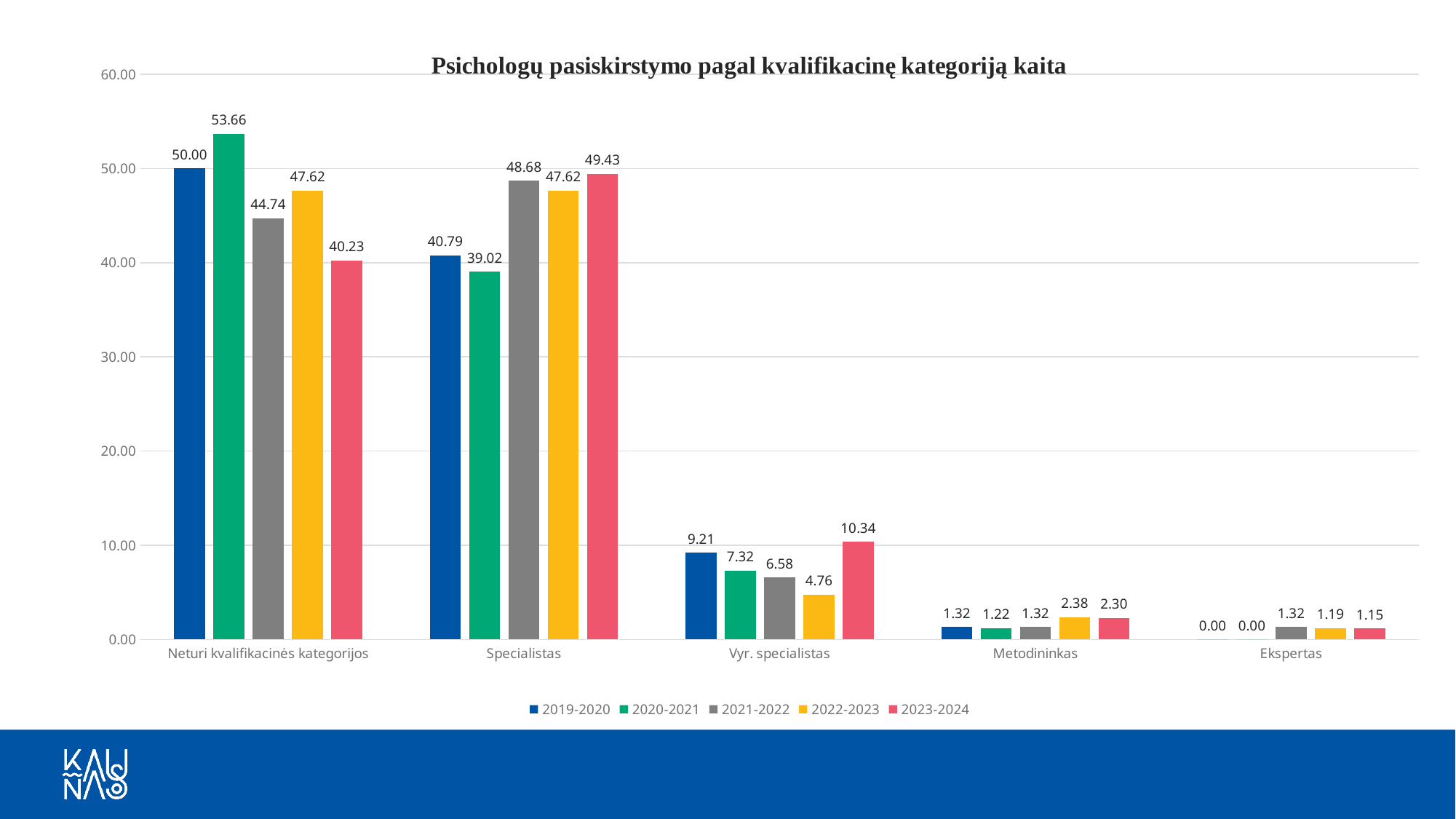
Which is larger for Specialistas: the 2019-2020 value or the 2023-2024 value? 2023-2024 Which category has the highest value in the 2020-2021 series? Neturi kvalifikacinės kategorijos Is the value for Vyr. specialistas in 2022-2023 greater or less than 10.00? less What kind of chart is shown on the slide? bar chart Which category has the lowest value in the 2023-2024 series? Ekspertas How many categories are shown on the x axis? 5 What is the value for Ekspertas in the 2019-2020 series? 0.00 What is the value for Specialistas in the 2021-2022 series? 48.68 What is the value for Vyr. specialistas in the 2023-2024 series? 10.34 What is the title of the chart? Psichologų pasiskirstymo pagal kvalifikacinę kategoriją kaita What is the difference between the 2020-2021 and 2023-2024 values for Neturi kvalifikacinės kategorijos? 13.43 How many series does the legend list? 5